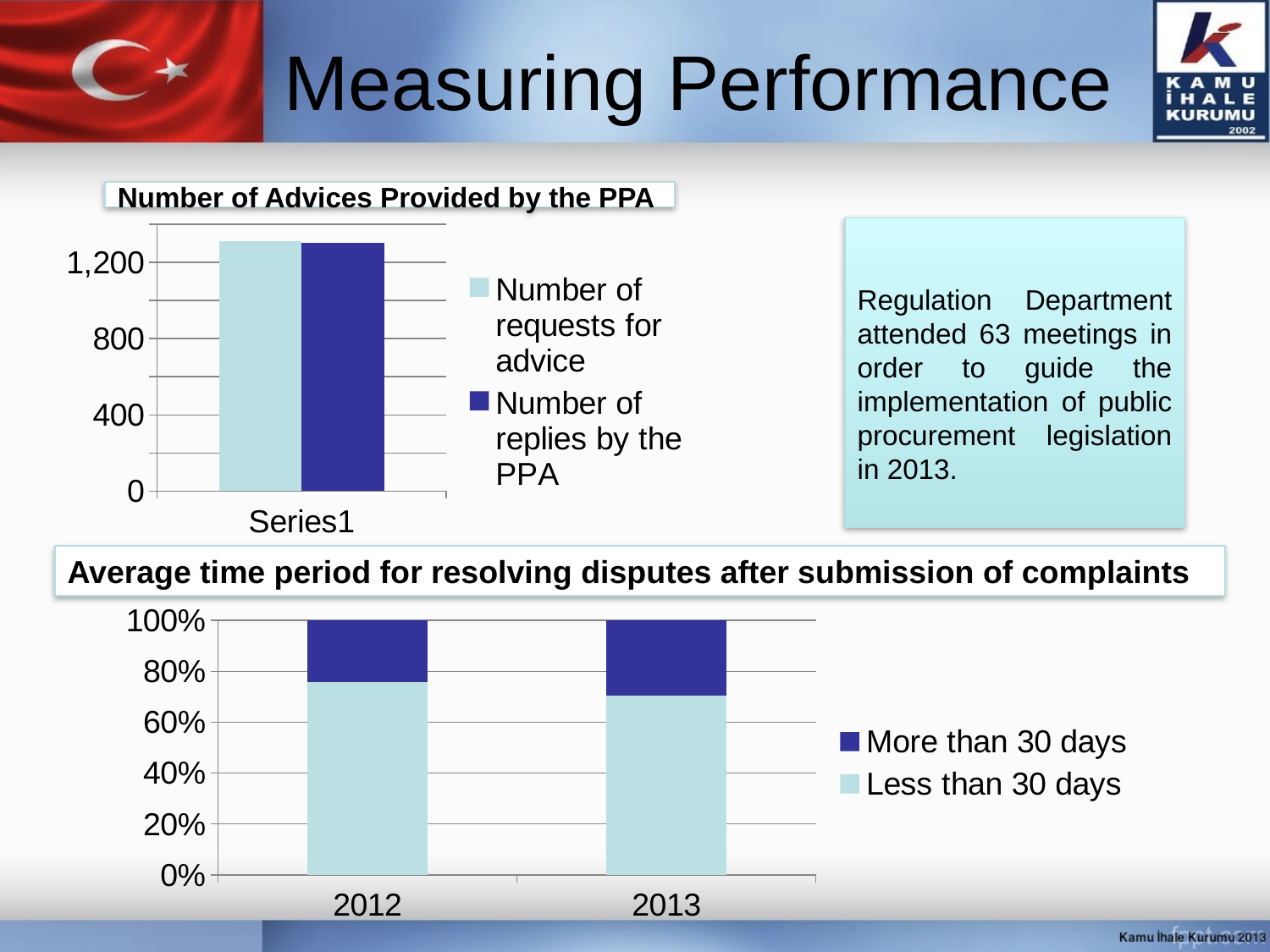
In the 'Average time period for resolving disputes after submission of complaints' chart, is the 'Less than 30 days' share for 2013 greater or less than 80%? less In the 'Number of Advices Provided by the PPA' chart, is the value for 'Number of requests for advice' greater or less than 1,200? greater How many series does the legend of the 'Number of Advices Provided by the PPA' chart list? 2 How many series does the legend of the 'Average time period for resolving disputes after submission of complaints' chart list? 2 In the 'Average time period for resolving disputes after submission of complaints' chart, does the 'Less than 30 days' share rise or fall from 2012 to 2013? fall In the 'Number of Advices Provided by the PPA' chart, is the value for 'Number of replies by the PPA' greater or less than 800? greater What is the category label shown on the x axis of the 'Number of Advices Provided by the PPA' chart? Series1 What type of chart is the 'Number of Advices Provided by the PPA' chart? bar chart What type of chart is the 'Average time period for resolving disputes after submission of complaints' chart? stacked bar chart In the 'Average time period for resolving disputes after submission of complaints' chart, which year has the larger 'More than 30 days' share, 2012 or 2013? 2013 How many categories are shown on the x axis of the 'Average time period for resolving disputes after submission of complaints' chart? 2